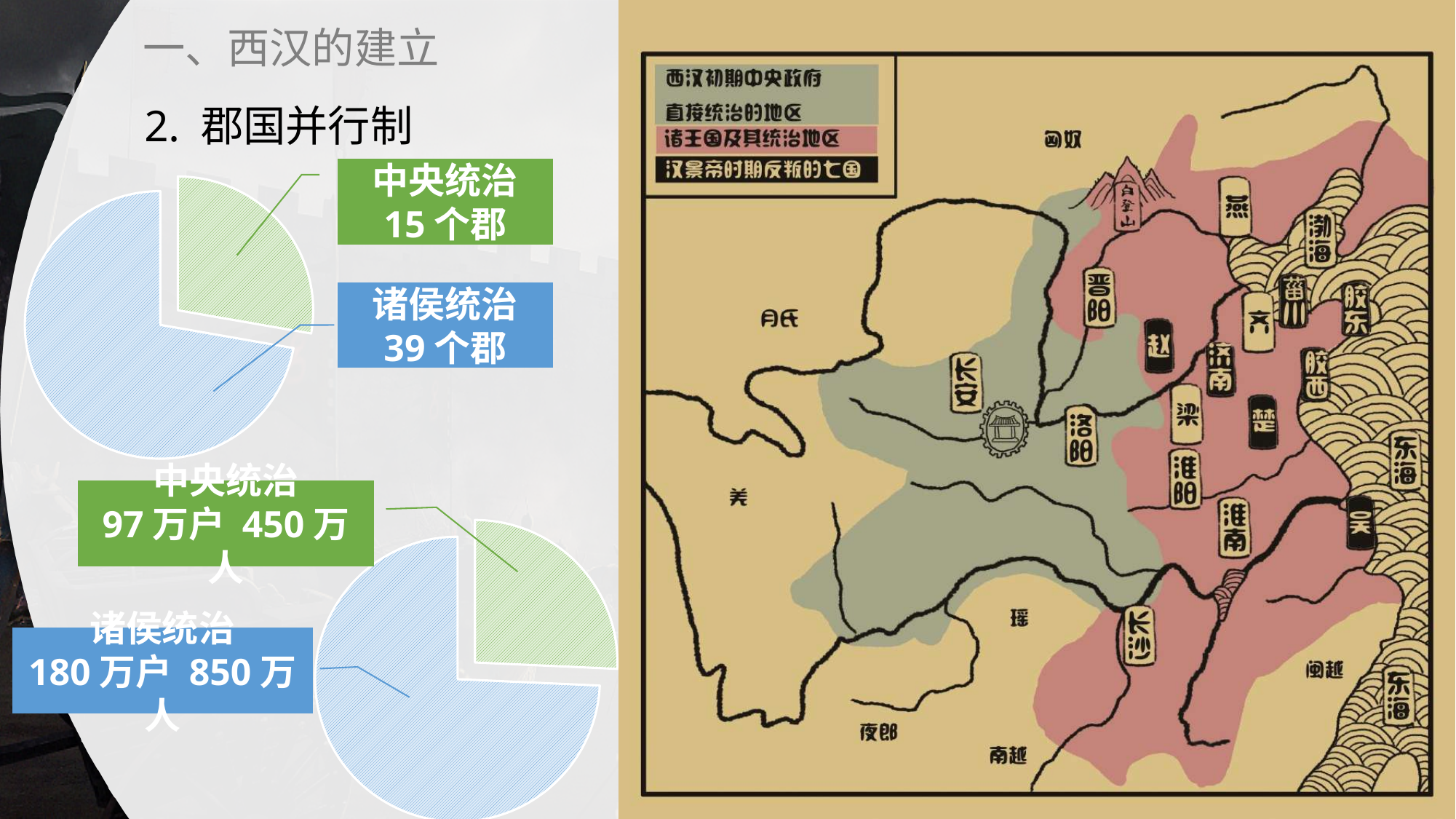
In the upper pie chart, how many 郡 are under 诸侯统治? 39 个郡 In the upper pie chart, which category has the larger slice, 中央统治 or 诸侯统治? 诸侯统治 In the upper pie chart, how many more 郡 are under 诸侯统治 than under 中央统治? 24 个郡 In the lower pie chart, how many more households does 诸侯统治 have than 中央统治? 83 万户 How many slices does the upper pie chart have? 2 What kind of chart is the upper chart on the left side of the slide? pie chart In the lower pie chart, how many people (人) are under 诸侯统治? 850 万人 In the lower pie chart, how many households (户) are under 中央统治? 97 万户 In the lower pie chart, what is the difference in population between 诸侯统治 (850 万人) and 中央统治 (450 万人)? 400 万人 In both pie charts, which colour represents 中央统治? green In the upper pie chart, how many 郡 are under 中央统治? 15 个郡 In the lower pie chart, which category has the smaller slice? 中央统治